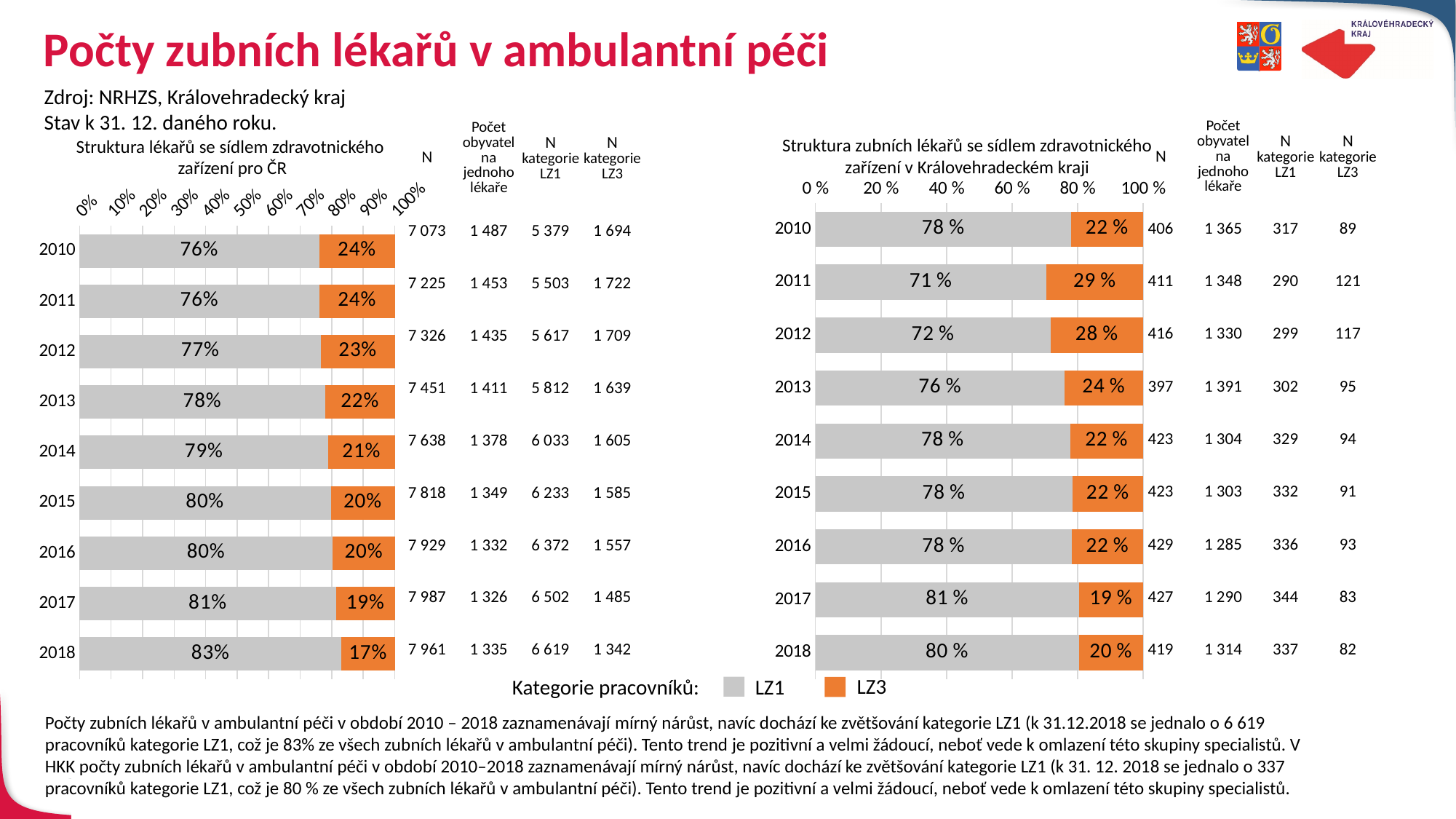
What type of chart is the right chart (v Královehradeckém kraji)? Stacked bar chart How many years are shown on the x-axis categories of the left chart (pro ČR)? 9 In the left chart (Struktura lékařů se sídlem zdravotnického zařízení pro ČR), what is the LZ1 share for 2018? 83% In the left chart (pro ČR), what is the difference between the LZ1 share in 2018 and in 2010? 7 percentage points In the right chart (v Královehradeckém kraji), which year has the lowest LZ1 share? 2011 In the right chart (v Královehradeckém kraji), what is the LZ1 share for 2017? 81 % In the right chart (v Královehradeckém kraji), what is the LZ3 share for 2011? 29 % In the left chart (pro ČR), which year has the highest LZ1 share? 2018 How many series does the legend 'Kategorie pracovníků' list? 2 In the right chart (v Královehradeckém kraji), is the LZ3 share larger in 2011 or in 2018? 2011 In the left chart (pro ČR), does the LZ3 share rise or fall from 2010 to 2018? Fall In the left chart (pro ČR), what is the LZ3 share for 2010? 24%